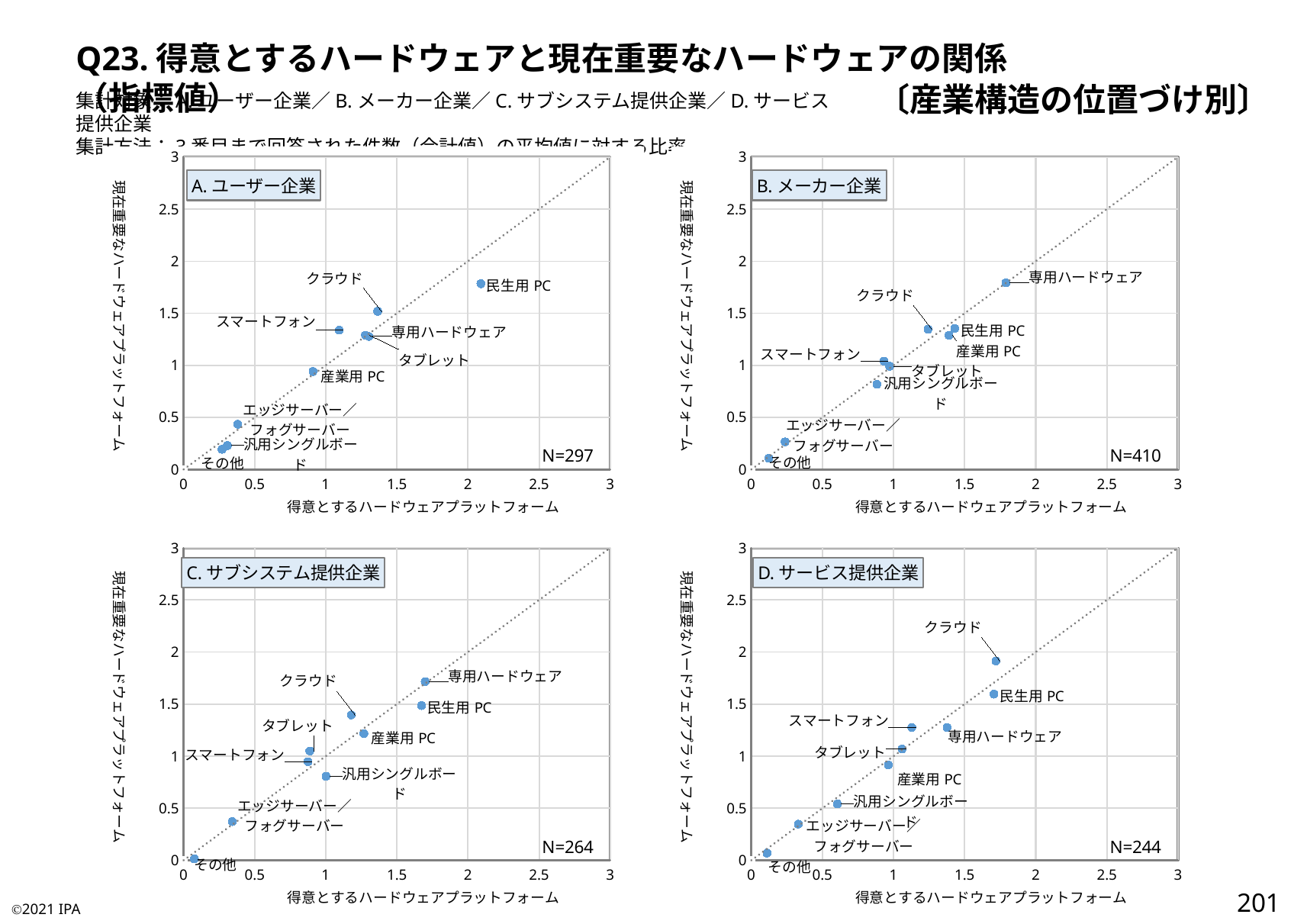
In the chart 'B. メーカー企業', which hardware platform has the highest value on the vertical axis? 専用ハードウェア What kind of chart is the top-left chart titled 'A. ユーザー企業'? scatter chart In the chart 'A. ユーザー企業', how many data points are plotted? 9 In the chart 'A. ユーザー企業', which hardware platform has the highest value on the vertical axis (現在重要なハードウェアプラットフォーム)? 民生用 PC What is the N value shown in the chart 'A. ユーザー企業'? N=297 In the chart 'C. サブシステム提供企業', which hardware platform has the lowest value on the vertical axis? その他 In the chart 'B. メーカー企業', is the horizontal-axis value for 専用ハードウェア greater or less than 1.5? greater In the chart 'C. サブシステム提供企業', is the vertical-axis value for 汎用シングルボード greater or less than 1? less In the chart 'A. ユーザー企業', is the horizontal-axis value for 民生用 PC greater or less than 2? greater In the chart 'D. サービス提供企業', which hardware platform has the highest value on the vertical axis? クラウド What is the title of the top-right chart? B. メーカー企業 In the chart 'D. サービス提供企業', which has the larger vertical-axis value, クラウド or スマートフォン? クラウド